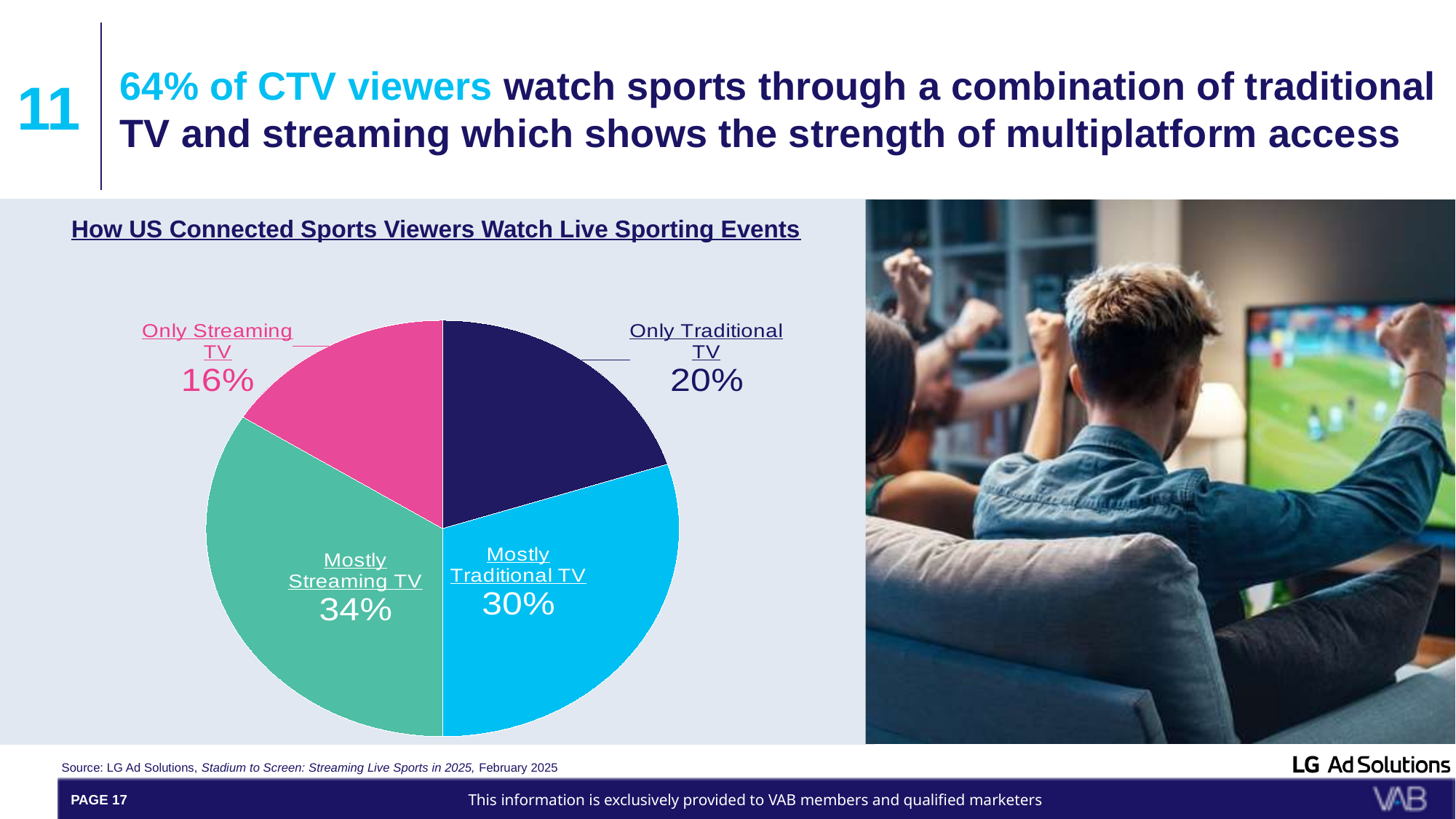
Which category has the largest share of the pie? Mostly Streaming TV Which category has the smallest share of the pie? Only Streaming TV What share of viewers watch live sporting events via Mostly Streaming TV? 34% What colour is the Only Streaming TV slice? Pink Which is larger, the share for Only Traditional TV or the share for Only Streaming TV? Only Traditional TV What is the title of the chart? How US Connected Sports Viewers Watch Live Sporting Events What share of viewers watch live sporting events via Mostly Traditional TV? 30% What share of viewers watch live sporting events via Only Streaming TV? 16% What is the difference in percentage points between Mostly Streaming TV and Only Streaming TV? 18 How many categories are shown in the pie chart? 4 What type of chart is shown on the slide? Pie chart What share of viewers watch live sporting events via Only Traditional TV? 20%